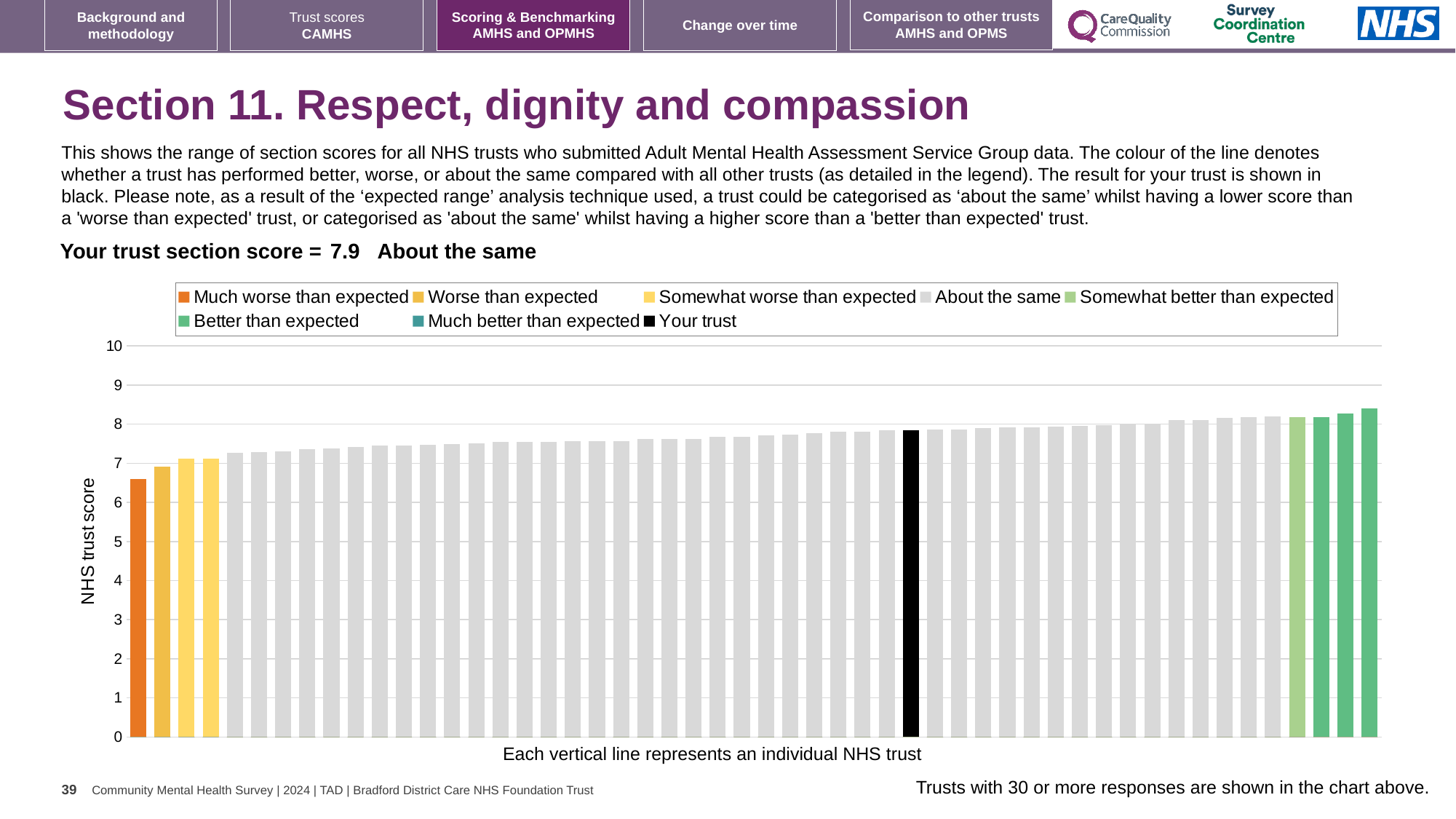
How many bars are coloured dark green ('Better than expected')? 3 How many bars are coloured orange ('Much worse than expected')? 1 What colour is used for the 'Your trust' bar in the chart? black What is the label on the vertical axis of the chart? NHS trust score Is the value for your trust (black bar) greater or less than 7? greater Do the bar values rise or fall from left to right along the x axis? rise What kind of chart is shown on the slide? bar chart Is the value of the highest (rightmost) bar greater or less than 8? greater What is the section score for your trust shown on the slide? 7.9 How many entries does the chart legend list? 8 Which is larger: the value for your trust (black bar) or the value of the orange 'Much worse than expected' bar? Your trust Is the value of the lowest (leftmost) bar greater or less than 7? less